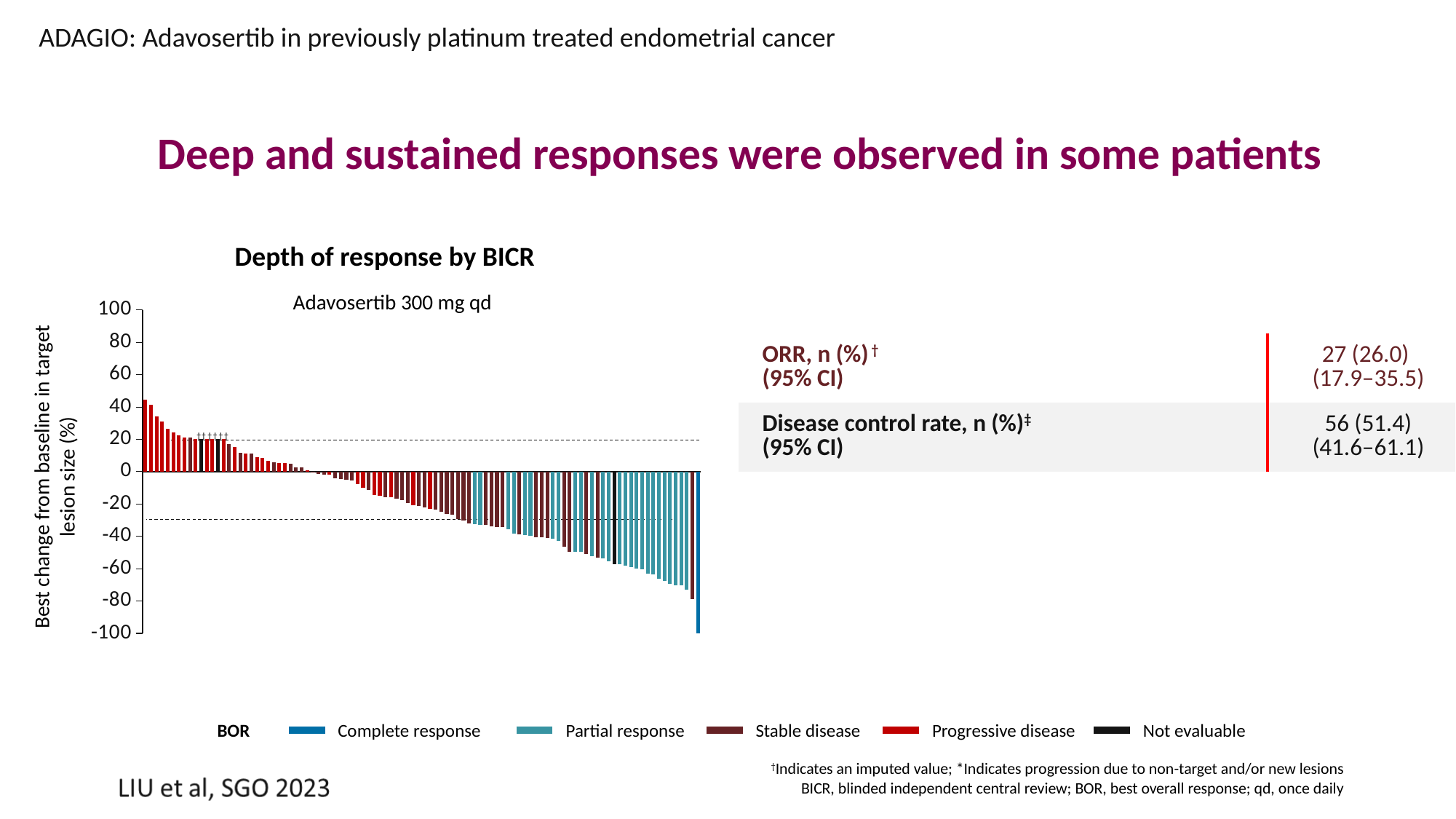
What is the title of the chart on the slide? Depth of response by BICR In the 'Depth of response by BICR' chart, is the value of the leftmost bar greater or less than 60? less In the 'Depth of response by BICR' chart, which BOR category does the bar with the highest value belong to? Progressive disease What dose label is printed above the 'Depth of response by BICR' chart? Adavosertib 300 mg qd How many BOR categories does the legend of the 'Depth of response by BICR' chart list? 5 What kind of chart is shown under the heading 'Depth of response by BICR'? Bar chart In the 'Depth of response by BICR' chart, is the value of the rightmost bar greater or less than -80? less In the 'Depth of response by BICR' chart, do the bar values rise or fall from left to right? Fall In the 'Depth of response by BICR' chart, is the value of the leftmost bar greater or less than 40? greater In the 'Depth of response by BICR' chart, which BOR category does the bar with the lowest value belong to? Complete response